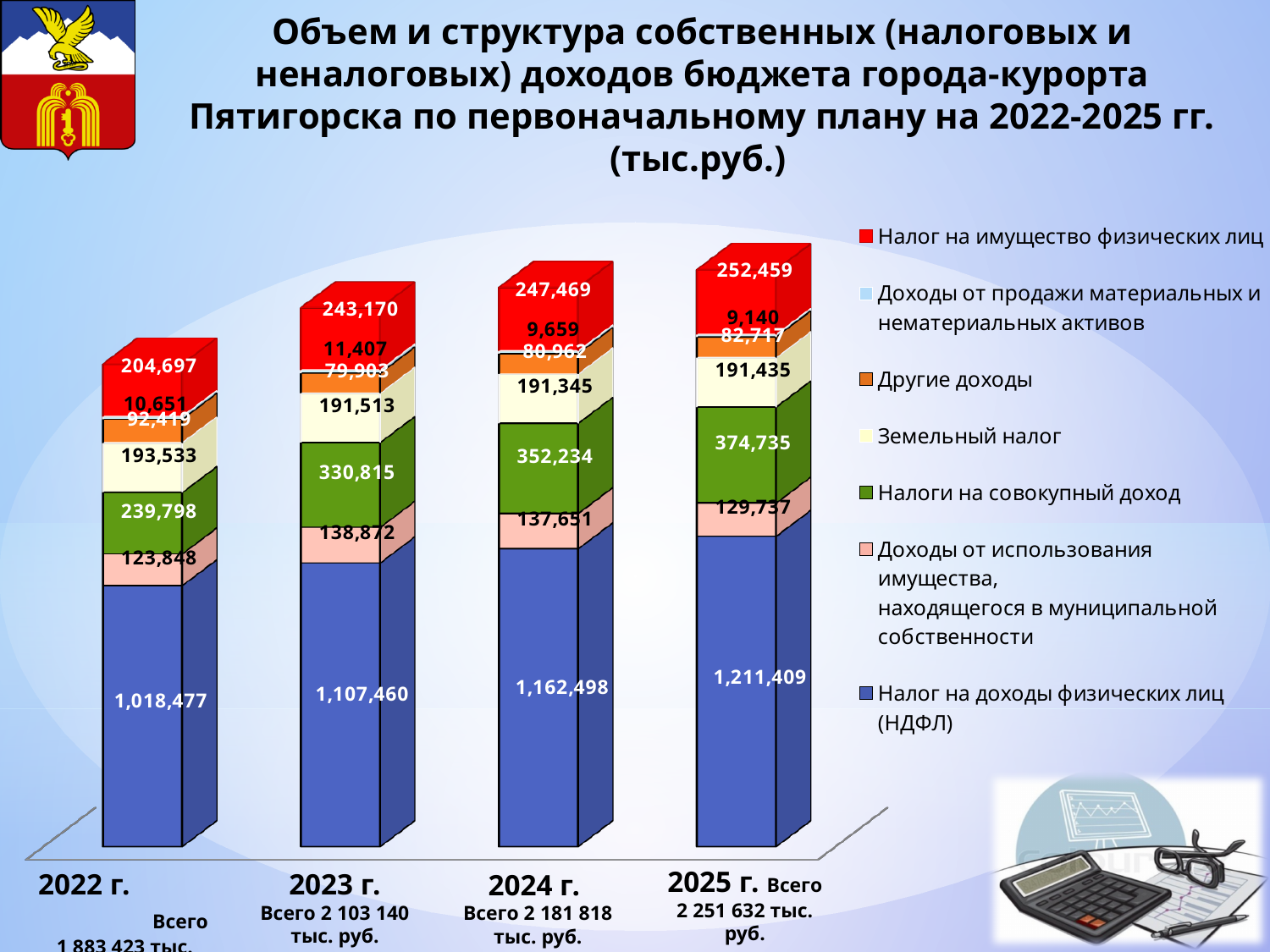
Which is larger: Земельный налог in 2022 г. or in 2023 г.? 2022 г. What kind of chart is shown on the slide? stacked bar chart What is the value of Налог на доходы физических лиц (НДФЛ) for 2022 г.? 1,018,477 What is the value of Налоги на совокупный доход for 2025 г.? 374,735 What is the value of Налог на имущество физических лиц for 2023 г.? 243,170 What is the difference between the НДФЛ value for 2025 г. and for 2022 г.? 192,932 In which year is the value of Налог на доходы физических лиц (НДФЛ) the highest? 2025 г. How many series does the legend list? 7 Which series has the smallest value in the 2024 г. bar? Доходы от продажи материальных и нематериальных активов Do the values of Налог на доходы физических лиц (НДФЛ) rise or fall from 2022 г. to 2025 г.? rise How many years (categories) are shown on the x axis? 4 What is the total of the stacked bar for 2024 г.? 2 181 818